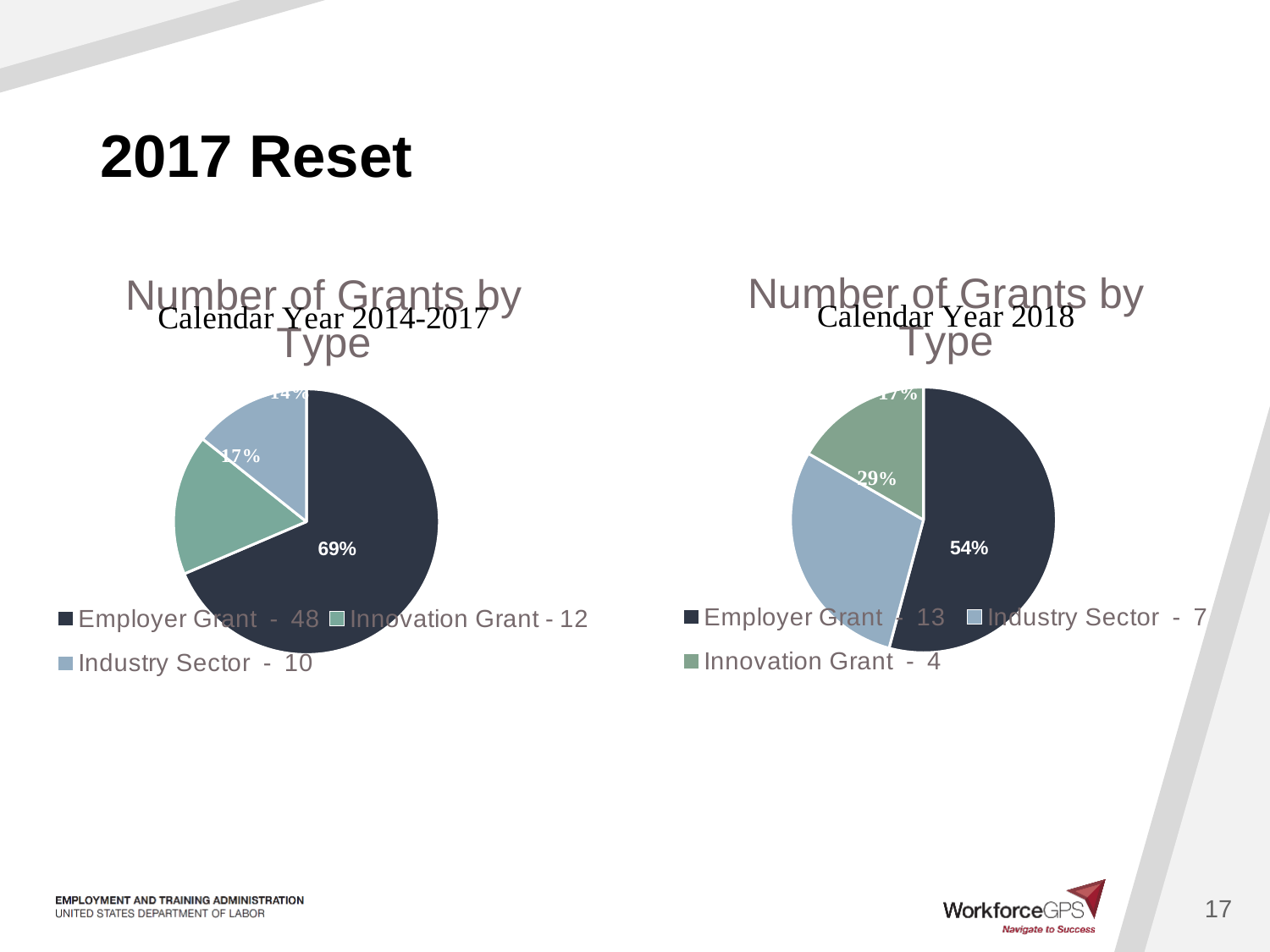
In the left chart (Calendar Year 2014-2017), what share of the pie is the Employer Grant slice? 69% In the left chart (Calendar Year 2014-2017), what is the difference between the number of Employer Grants and Innovation Grants? 36 In the right chart (Calendar Year 2018), how many grants are Industry Sector grants according to the legend? 7 In the right chart (Calendar Year 2018), what share of the pie is the Industry Sector slice? 29% How many slices does the right chart (Calendar Year 2018) have? 3 In the left chart (Calendar Year 2014-2017), how many grants are Innovation Grants according to the legend? 12 In the left chart (Calendar Year 2014-2017), how many grants are Employer Grants according to the legend? 48 In the right chart (Calendar Year 2018), which has more grants, Industry Sector or Innovation Grant? Industry Sector In the left chart (Calendar Year 2014-2017), which grant type has the fewest grants? Industry Sector What type of chart is used on the left (Calendar Year 2014-2017) chart? pie chart In the right chart (Calendar Year 2018), which grant type has the most grants? Employer Grant In the right chart (Calendar Year 2018), how many grants are Employer Grants according to the legend? 13